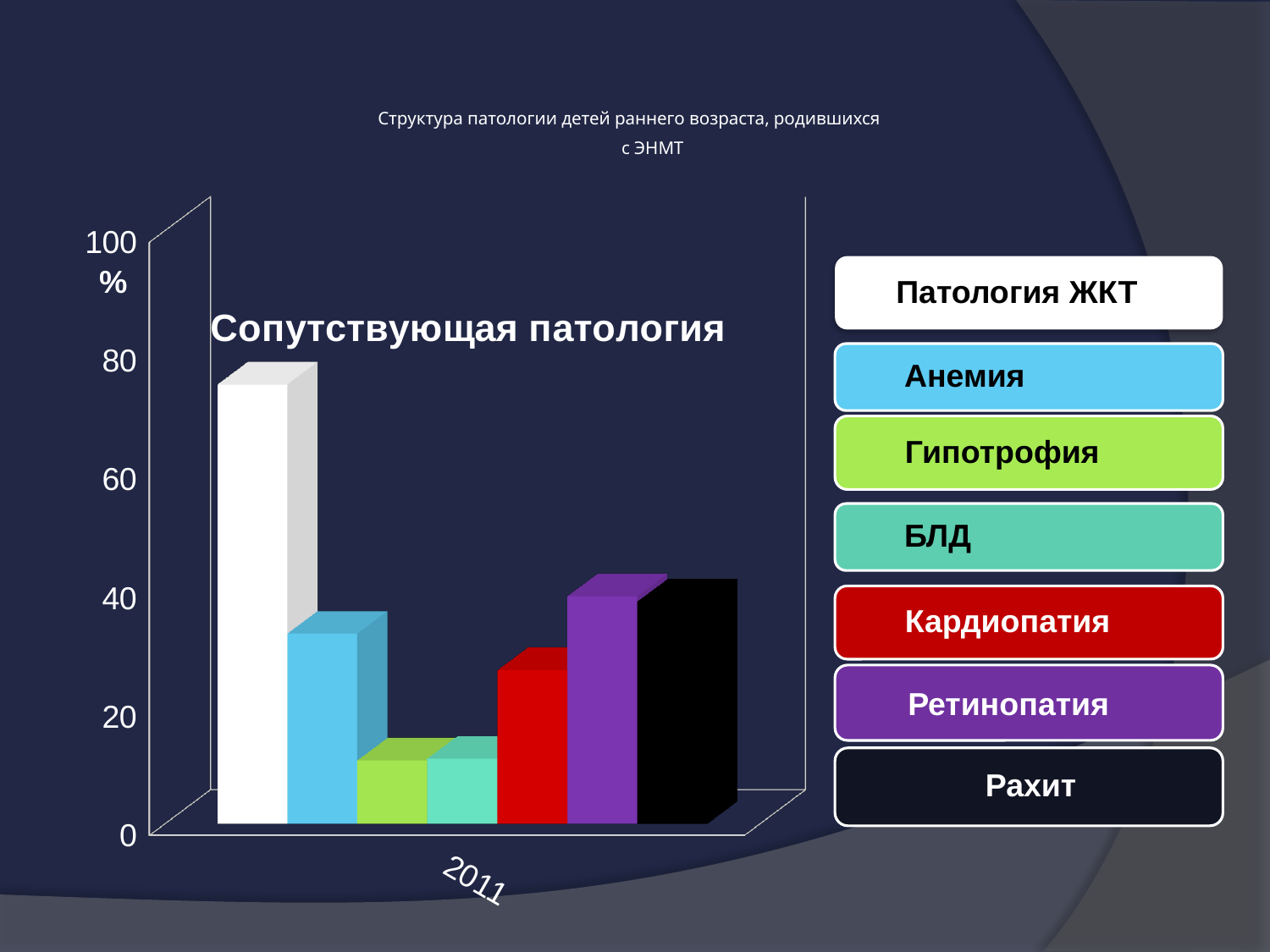
What kind of chart is shown on the slide? bar chart Is the value for Ретинопатия in 2011 greater or less than 60? less Is the value for Патология ЖКТ in 2011 greater or less than 60? greater Is the value for Гипотрофия in 2011 greater or less than 20? less How many series does the legend list? 7 Which is larger in 2011, Кардиопатия or БЛД? Кардиопатия What is the category label on the x axis? 2011 Which is larger in 2011, Патология ЖКТ or Анемия? Патология ЖКТ Which series has the highest value in 2011? Патология ЖКТ How many categories are shown on the x axis? 1